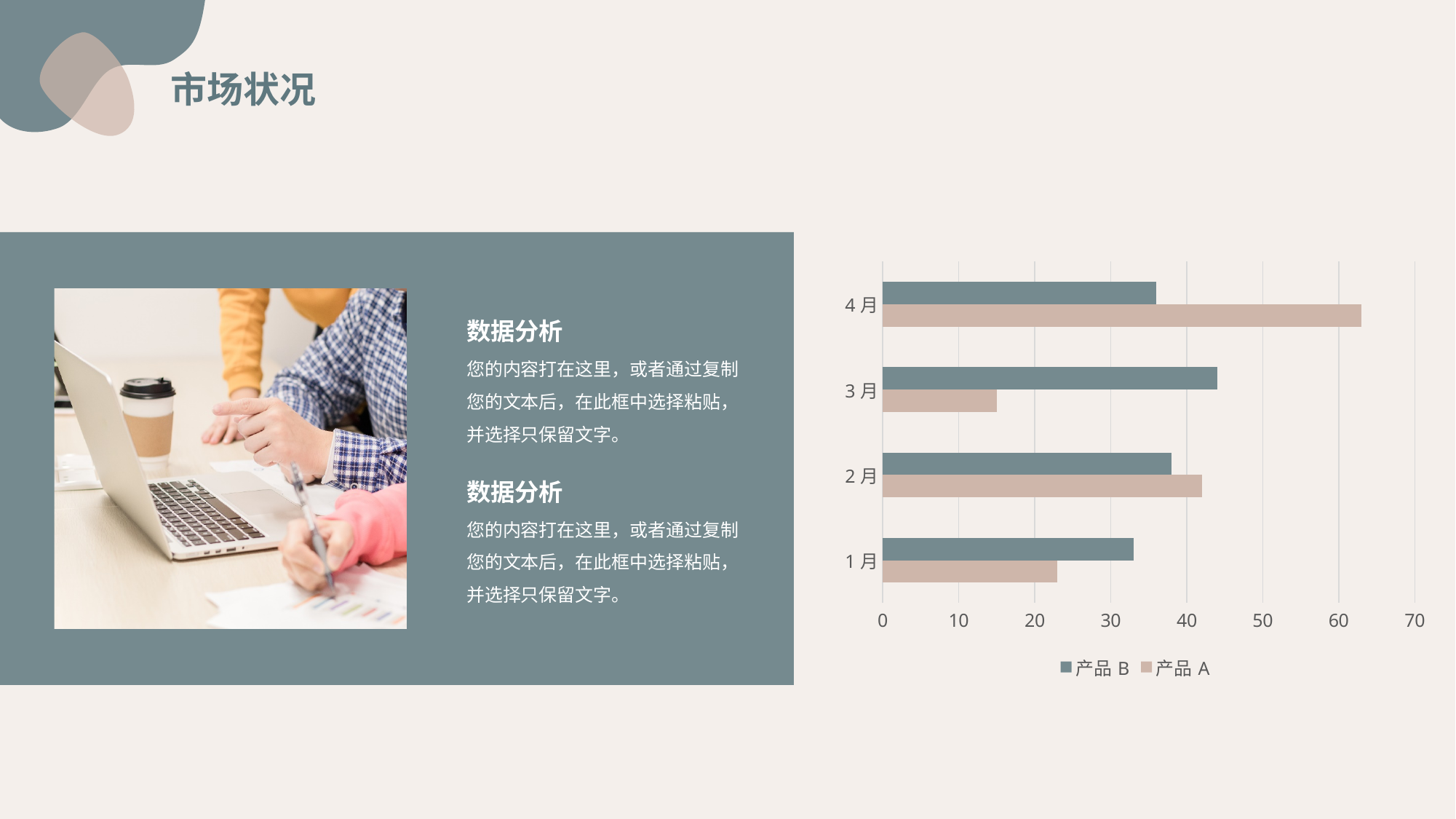
How many categories (months) are shown on the chart? 4 Is the value for 产品 A in 4月 greater or less than 50? greater Is the value for 产品 A in 3月 greater or less than 20? less Which series is shown in the teal colour in the legend? 产品 B In 4月, which series has the larger value, 产品 A or 产品 B? 产品 A In 3月, which series has the larger value, 产品 A or 产品 B? 产品 B How many series does the chart legend list? 2 Which month has the highest value for 产品 A? 4月 What kind of chart is shown on the slide? bar chart Which month has the lowest value for 产品 A? 3月 In 1月, which series has the larger value, 产品 A or 产品 B? 产品 B Which month has the highest value for 产品 B? 3月